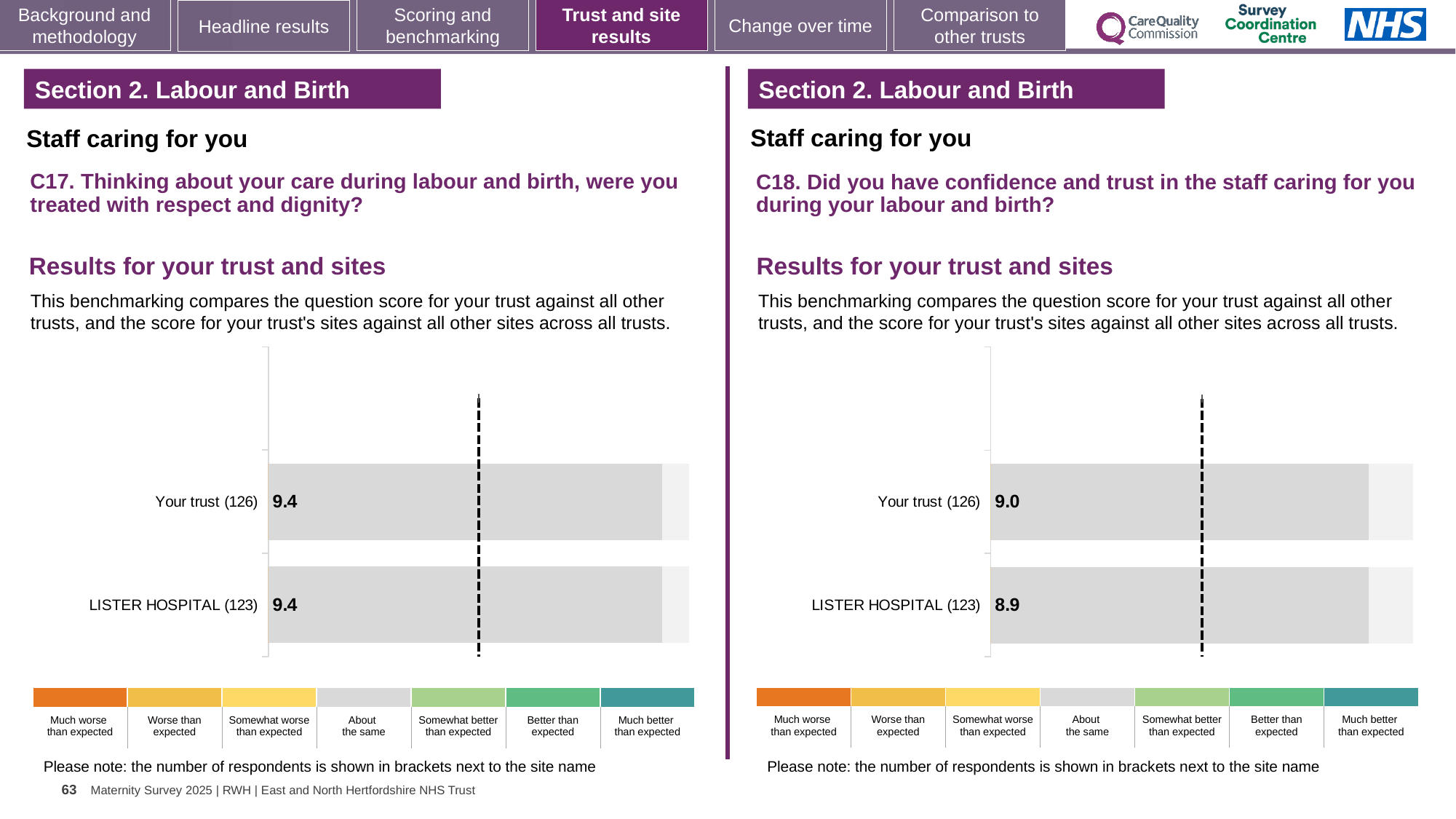
On the C18 chart (right), what is the score for Your trust (126)? 9.0 On the C17 chart (left), what is the score for Your trust (126)? 9.4 On the C17 chart (left), what is the score for LISTER HOSPITAL (123)? 9.4 How many bars are plotted on the C17 chart (left)? 2 How many respondents are shown in brackets for LISTER HOSPITAL on the C17 chart (left)? 123 On the C17 chart (left), what is the difference between the score for Your trust (126) and the score for LISTER HOSPITAL (123)? 0 On the C18 chart (right), which has the higher score, Your trust (126) or LISTER HOSPITAL (123)? Your trust (126) How many categories does the colour key below the C18 chart (right) list? 7 On the C18 chart (right), what is the difference between the score for Your trust (126) and the score for LISTER HOSPITAL (123)? 0.1 On the C18 chart (right), what is the score for LISTER HOSPITAL (123)? 8.9 What type of chart is used on the C18 chart (right)? Bar chart How many bars are plotted on the C18 chart (right)? 2